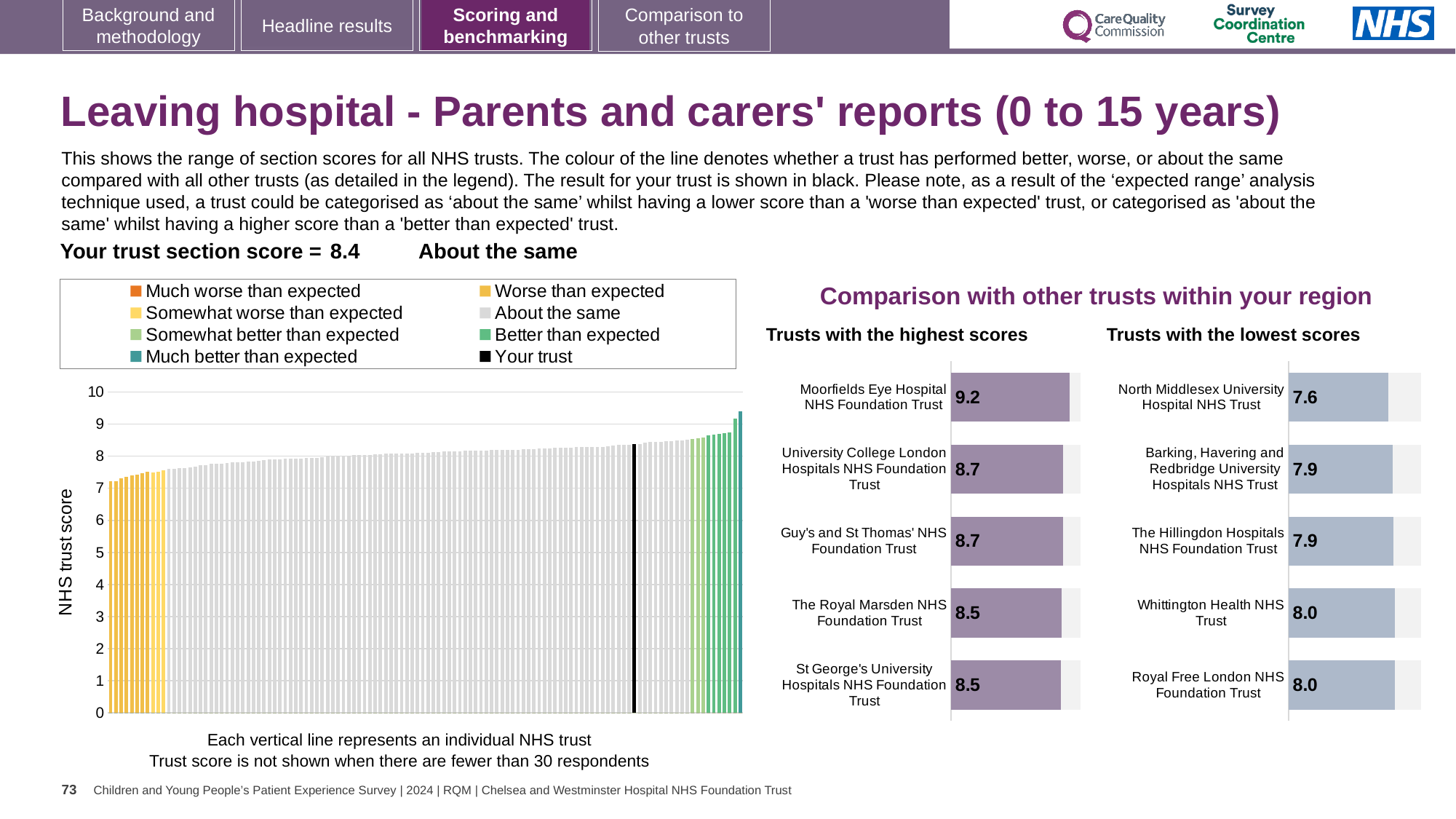
In the main chart on the left showing all NHS trusts, what is the section score for your trust (the black line)? 8.4 In the 'Trusts with the lowest scores' chart, what is the difference between the scores of Royal Free London NHS Foundation Trust and North Middlesex University Hospital NHS Trust? 0.4 What kind of chart is the 'Trusts with the highest scores' chart? bar chart In the 'Trusts with the lowest scores' chart, what is the score for North Middlesex University Hospital NHS Trust? 7.6 In the 'Trusts with the highest scores' chart, what is the difference between the scores of Moorfields Eye Hospital NHS Foundation Trust and St George's University Hospitals NHS Foundation Trust? 0.7 In the main chart on the left showing all NHS trusts, do the scores rise or fall from left to right? rise In the 'Trusts with the highest scores' chart, which has the larger score: Moorfields Eye Hospital NHS Foundation Trust or The Royal Marsden NHS Foundation Trust? Moorfields Eye Hospital NHS Foundation Trust In the 'Trusts with the lowest scores' chart, which trust has the lowest score? North Middlesex University Hospital NHS Trust In the 'Trusts with the highest scores' chart, what is the score for Moorfields Eye Hospital NHS Foundation Trust? 9.2 In the 'Trusts with the highest scores' chart, which trust has the highest score? Moorfields Eye Hospital NHS Foundation Trust In the main chart on the left showing all NHS trusts, is the value of the tallest line greater or less than 9? greater How many trusts are shown in the 'Trusts with the lowest scores' chart? 5